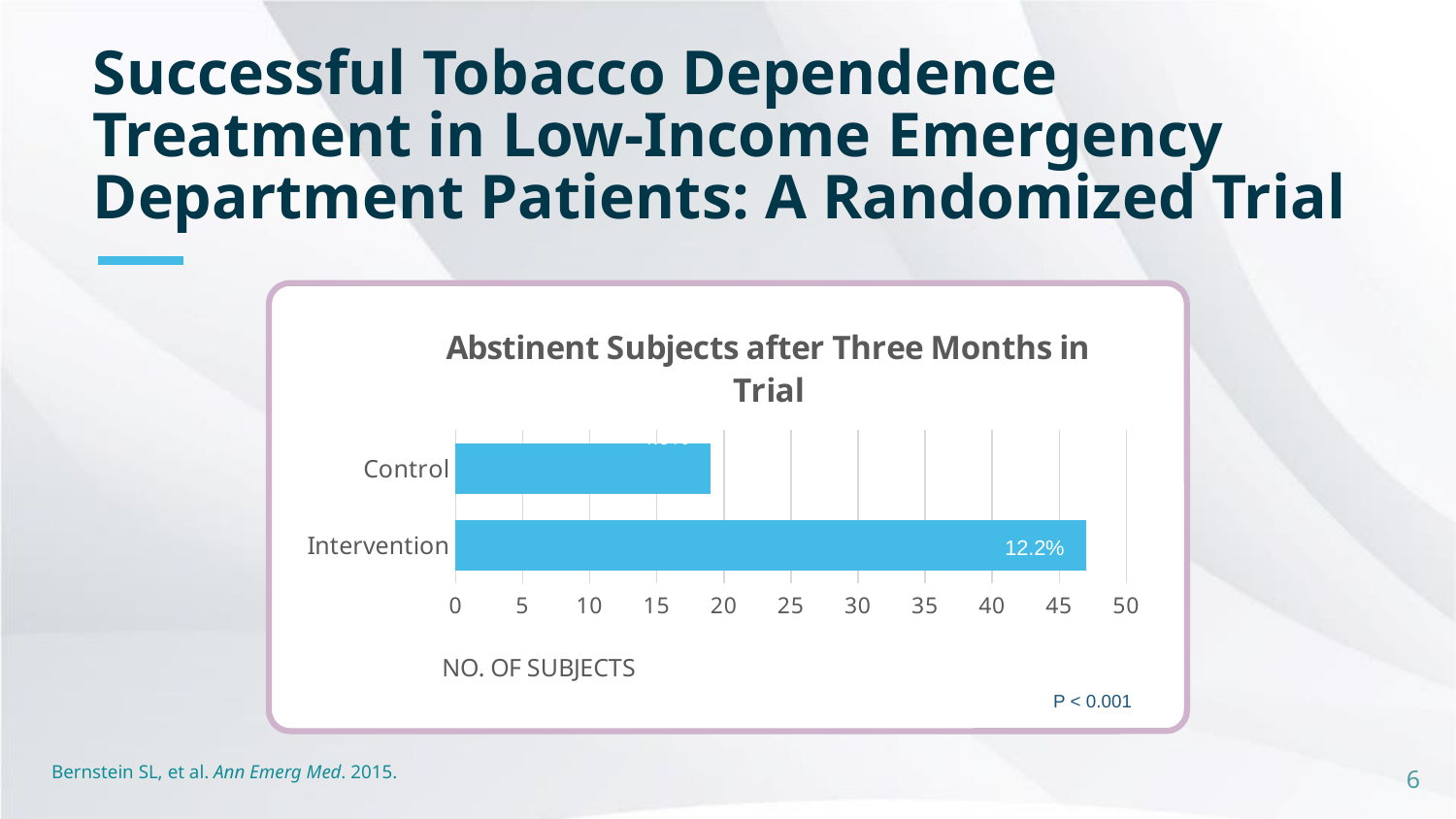
Which category has the highest number of subjects? Intervention How many categories are plotted in the chart? 2 Which has more abstinent subjects, Control or Intervention? Intervention What is the highest tick value shown on the horizontal axis? 50 Which category has the lowest number of subjects? Control Is the value for Control greater or less than 25? less What data label is printed on the Intervention bar? 12.2% Is the value for Control greater or less than 15? greater Is the value for Intervention greater or less than 40? greater What is the label of the horizontal axis? NO. OF SUBJECTS What kind of chart is shown on the slide? bar chart What is the title of the chart? Abstinent Subjects after Three Months in Trial